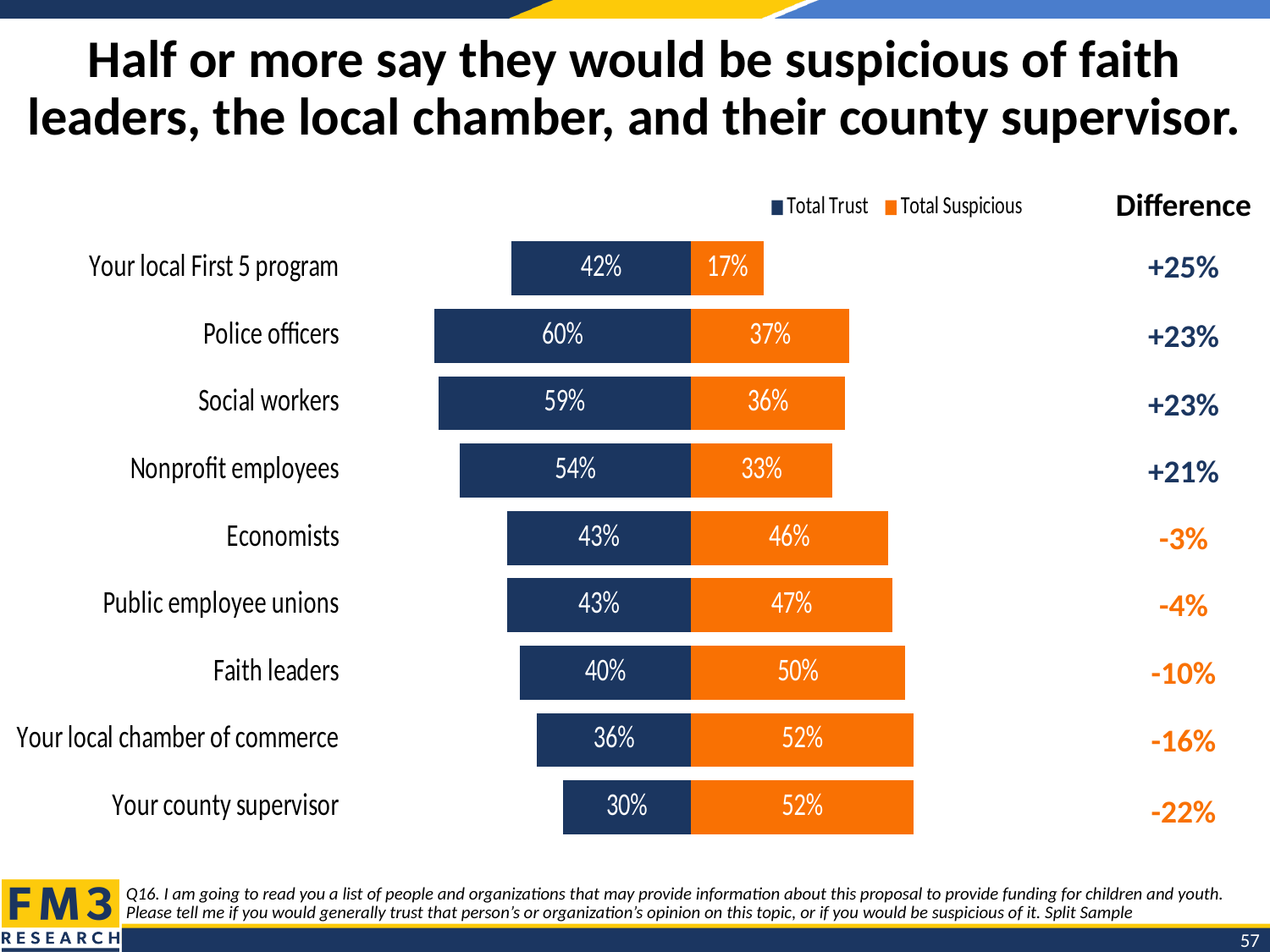
Which category has the lowest Total Suspicious value? Your local First 5 program What kind of chart is shown on the slide? Bar chart Which category has the lowest Total Trust value? Your county supervisor How many series does the legend list? 2 Which is larger for Economists, Total Trust or Total Suspicious? Total Suspicious What is the Total Suspicious value for Your local First 5 program? 17% Which category has the highest Total Trust value? Police officers What is the difference between Total Trust and Total Suspicious for Nonprofit employees? 21% What is the Total Suspicious value for Faith leaders? 50% What is the Total Trust value for Police officers? 60% What is the Difference value shown for Your local chamber of commerce? -16% How many categories are shown in the chart? 9